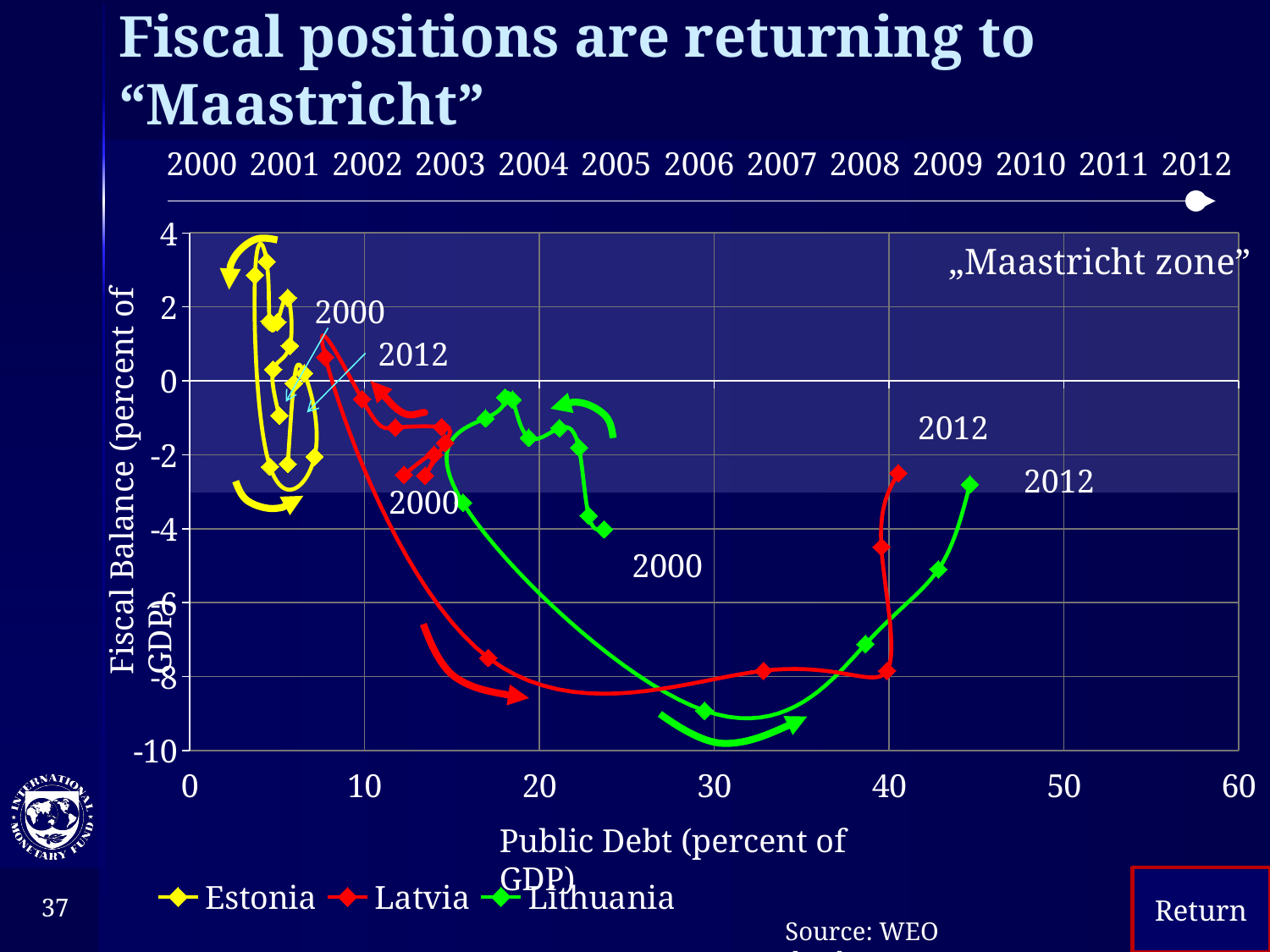
Which country has the higher public debt in 2012, Latvia or Lithuania? Lithuania What is the label of the horizontal axis? Public Debt (percent of GDP) Is Latvia's public debt in 2012 greater or less than 30? greater Which country has the highest fiscal balance at any point in the chart? Estonia How many years are shown on the timeline above the chart? 13 Is Estonia's public debt in 2012 greater or less than 10? less What kind of chart is shown on the slide? Scatter (line) chart How many countries does the legend list? 3 Is Lithuania's lowest fiscal balance greater or less than -8? less Which countries are listed in the chart legend? Estonia, Latvia, Lithuania Which country has the lowest public debt across all years shown? Estonia